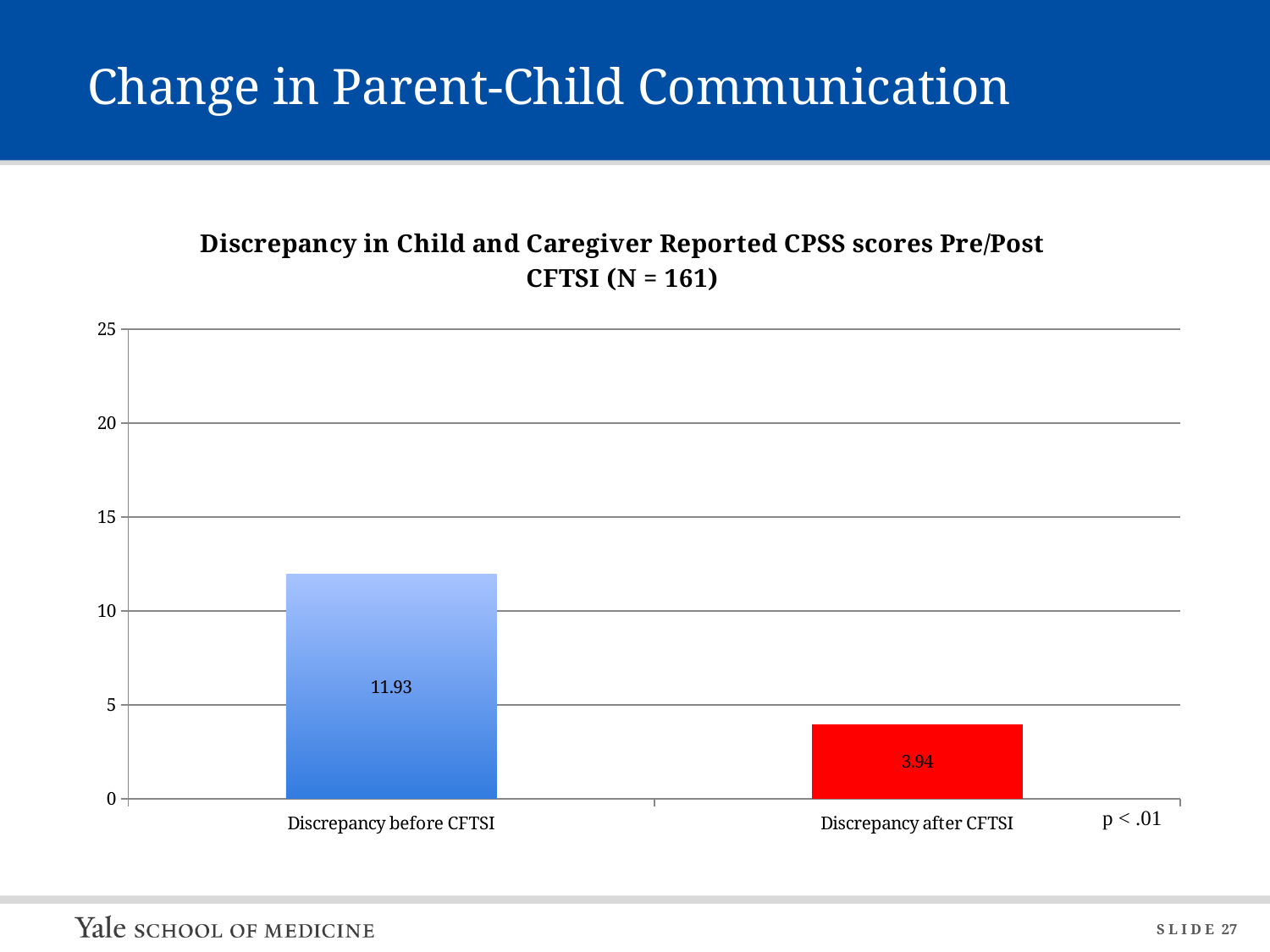
What is the value for Discrepancy after CFTSI? 3.94 Is the value for Discrepancy before CFTSI greater or less than 10? greater Which is larger, the value for Discrepancy before CFTSI or the value for Discrepancy after CFTSI? Discrepancy before CFTSI What is the value for Discrepancy before CFTSI? 11.93 What is the title of the chart? Discrepancy in Child and Caregiver Reported CPSS scores Pre/Post CFTSI (N = 161) Which category has the lowest value? Discrepancy after CFTSI What is the difference between the value for Discrepancy before CFTSI and the value for Discrepancy after CFTSI? 7.99 How many categories are shown on the chart? 2 Which category has the highest value? Discrepancy before CFTSI Do the values rise or fall from Discrepancy before CFTSI to Discrepancy after CFTSI? fall Is the value for Discrepancy after CFTSI greater or less than 5? less What kind of chart is shown on the slide? bar chart